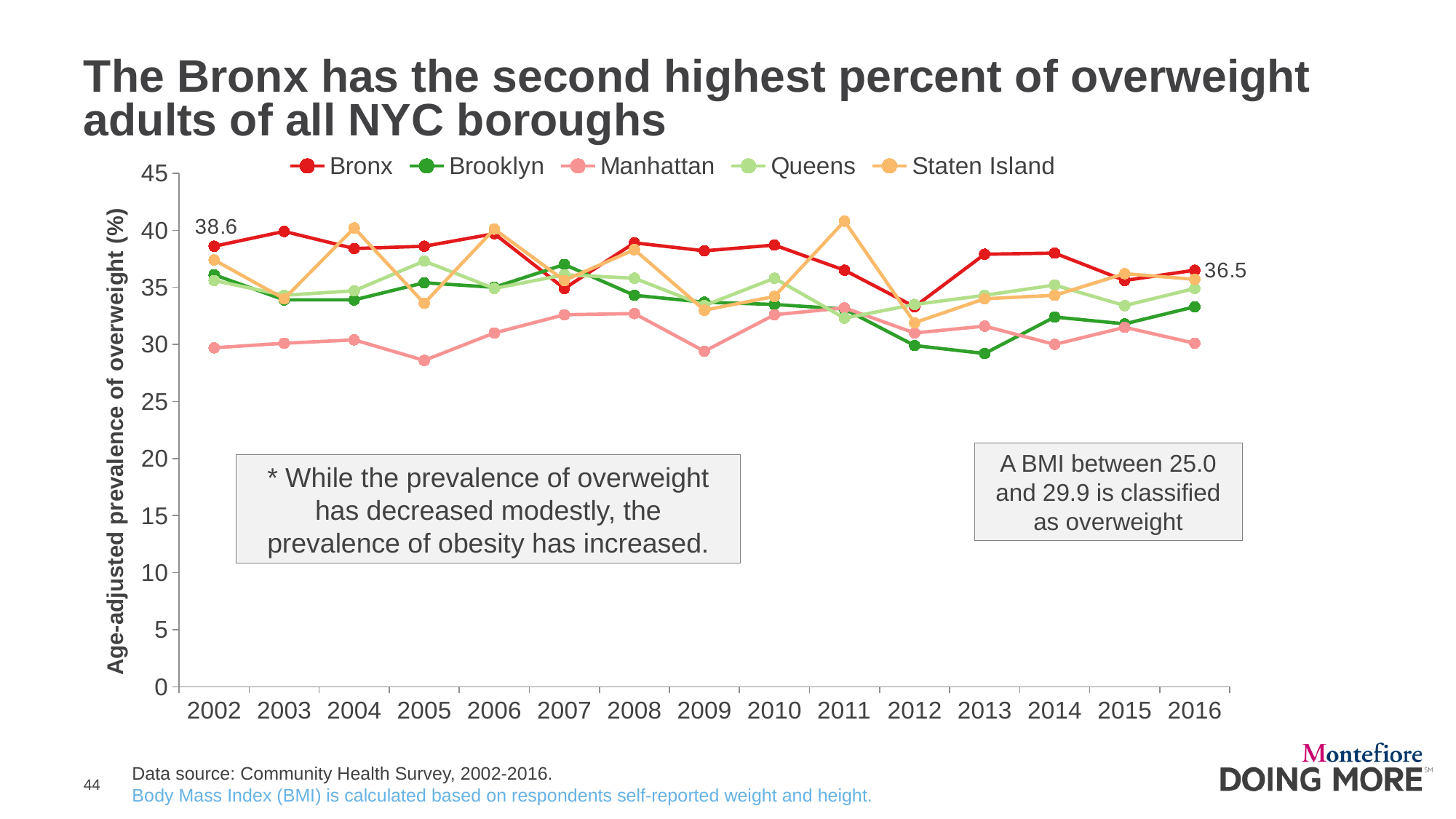
What kind of chart is shown on the slide? Line chart Is the value for Manhattan in 2005 greater or less than 30? less What is the Bronx's age-adjusted prevalence of overweight in 2016? 36.5 Which borough had the lowest prevalence of overweight in 2002? Manhattan By how much did the Bronx's prevalence of overweight decrease from 2002 to 2016? 2.1 How many boroughs are listed in the chart legend? 5 Which borough had the highest prevalence of overweight in 2011? Staten Island Is the value for Staten Island in 2011 greater or less than 40? greater Did the Bronx's prevalence of overweight rise or fall between 2002 and 2016? Fall What is the title of the y axis of the chart? Age-adjusted prevalence of overweight (%) How many years are shown on the x axis of the chart? 15 What is the Bronx's age-adjusted prevalence of overweight in 2002? 38.6